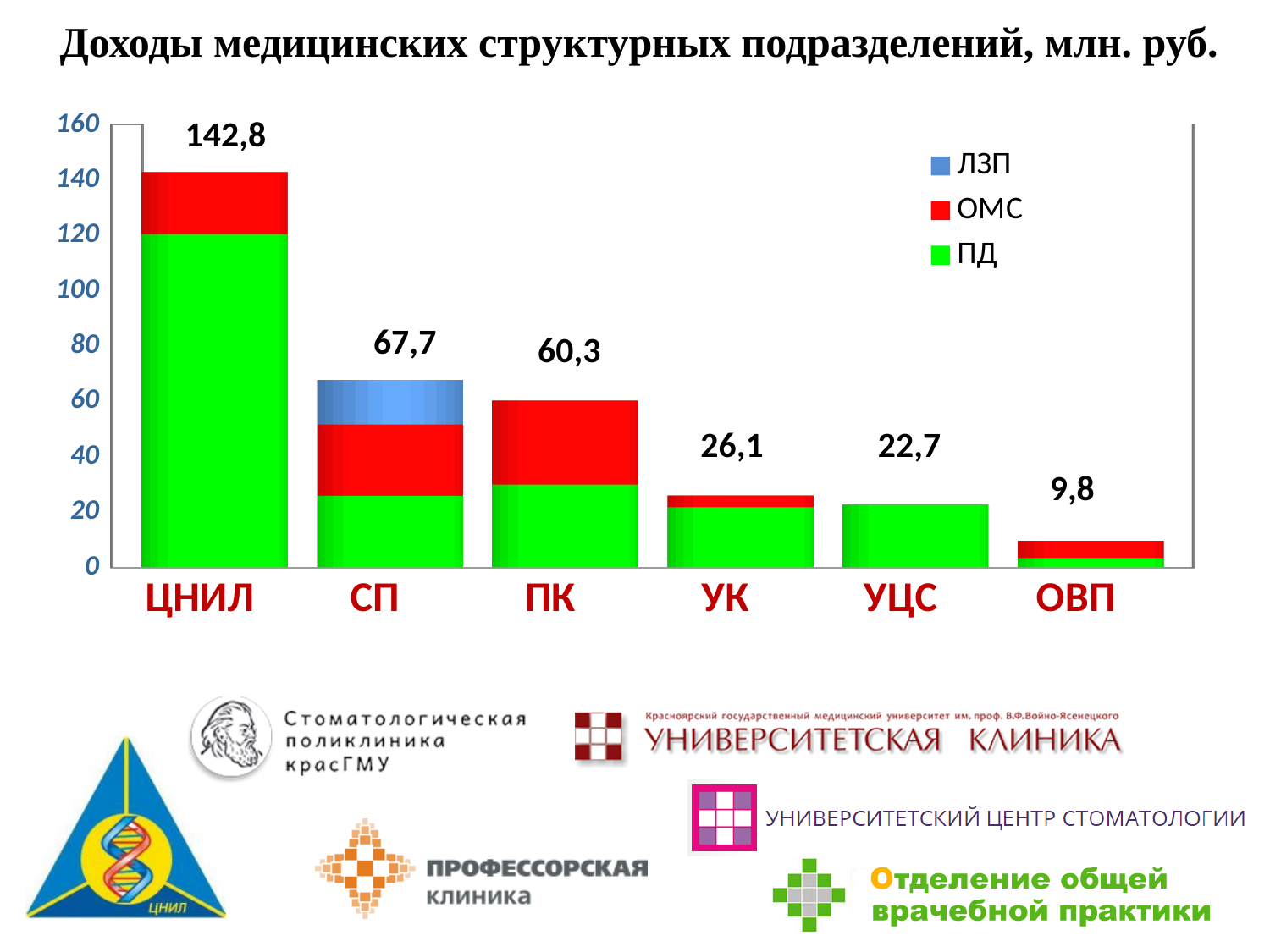
What is the difference between the total income of ЦНИЛ and СП? 75,1 How many divisions are shown on the x axis? 6 What is the total income shown for ЦНИЛ? 142,8 Which division has the lowest total income? ОВП What is the total income shown for ОВП? 9,8 What is the total income shown for СП? 67,7 Is the ПД (green) value for ЦНИЛ greater or less than 100? greater What is the difference between the total income of УК and УЦС? 3,4 How many series does the legend list? 3 Which has a larger total income, СП or ПК? СП Which division has the highest total income? ЦНИЛ What kind of chart is shown on the slide? stacked bar chart